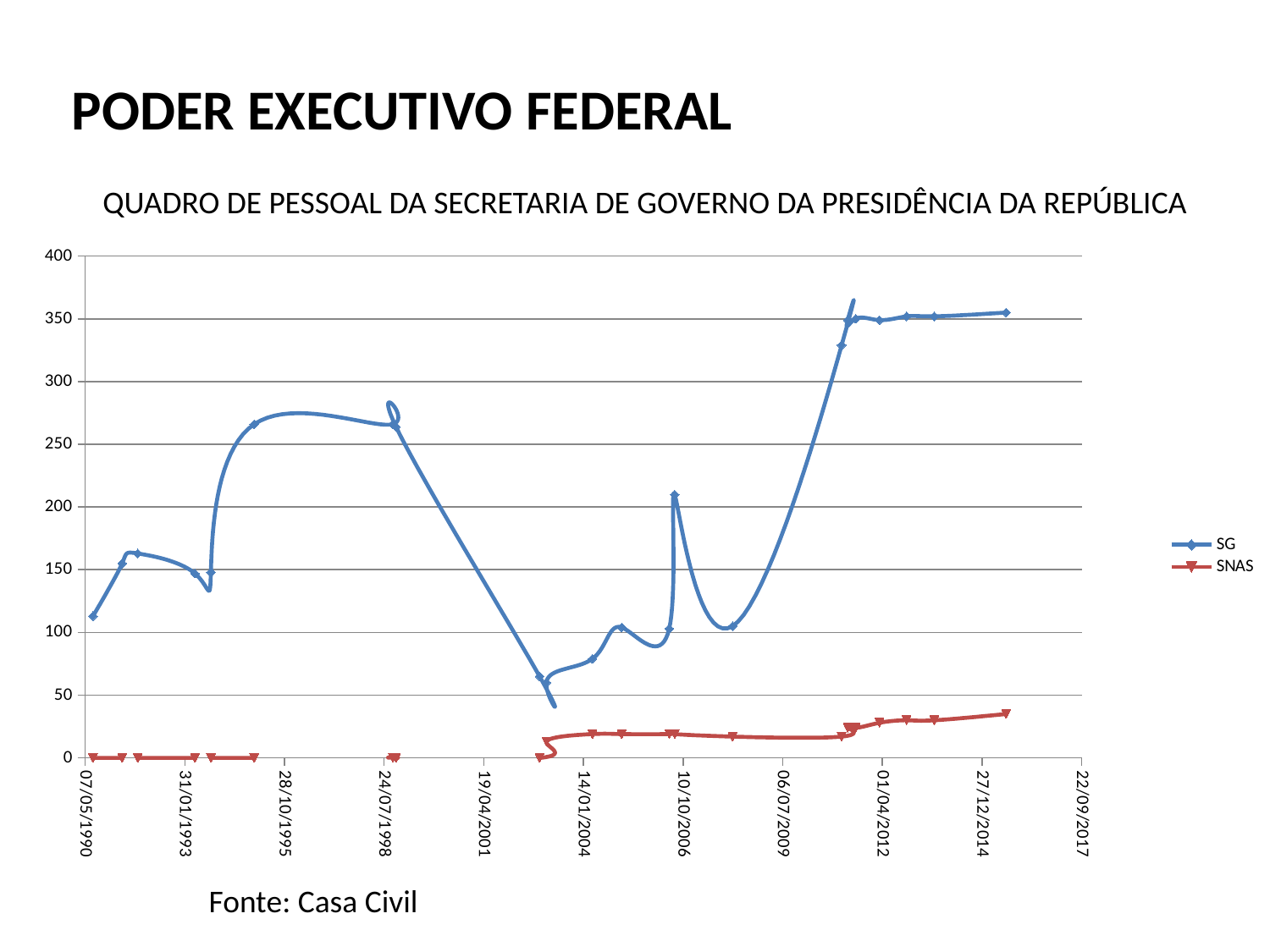
Is the SG value around 24/07/1998 greater or less than 200? greater Is the SG value at 07/05/1990 greater or less than 150? less Is the SNAS value at 07/05/1990 greater or less than 50? less Which series has the higher values around 01/04/2012, SG or SNAS? SG What kind of chart is shown on the slide? line chart What are the two series named in the legend? SG and SNAS How many series does the legend list? 2 Does the SG series rise or fall between 24/07/1998 and 2003? fall What is the title of the chart? QUADRO DE PESSOAL DA SECRETARIA DE GOVERNO DA PRESIDÊNCIA DA REPÚBLICA